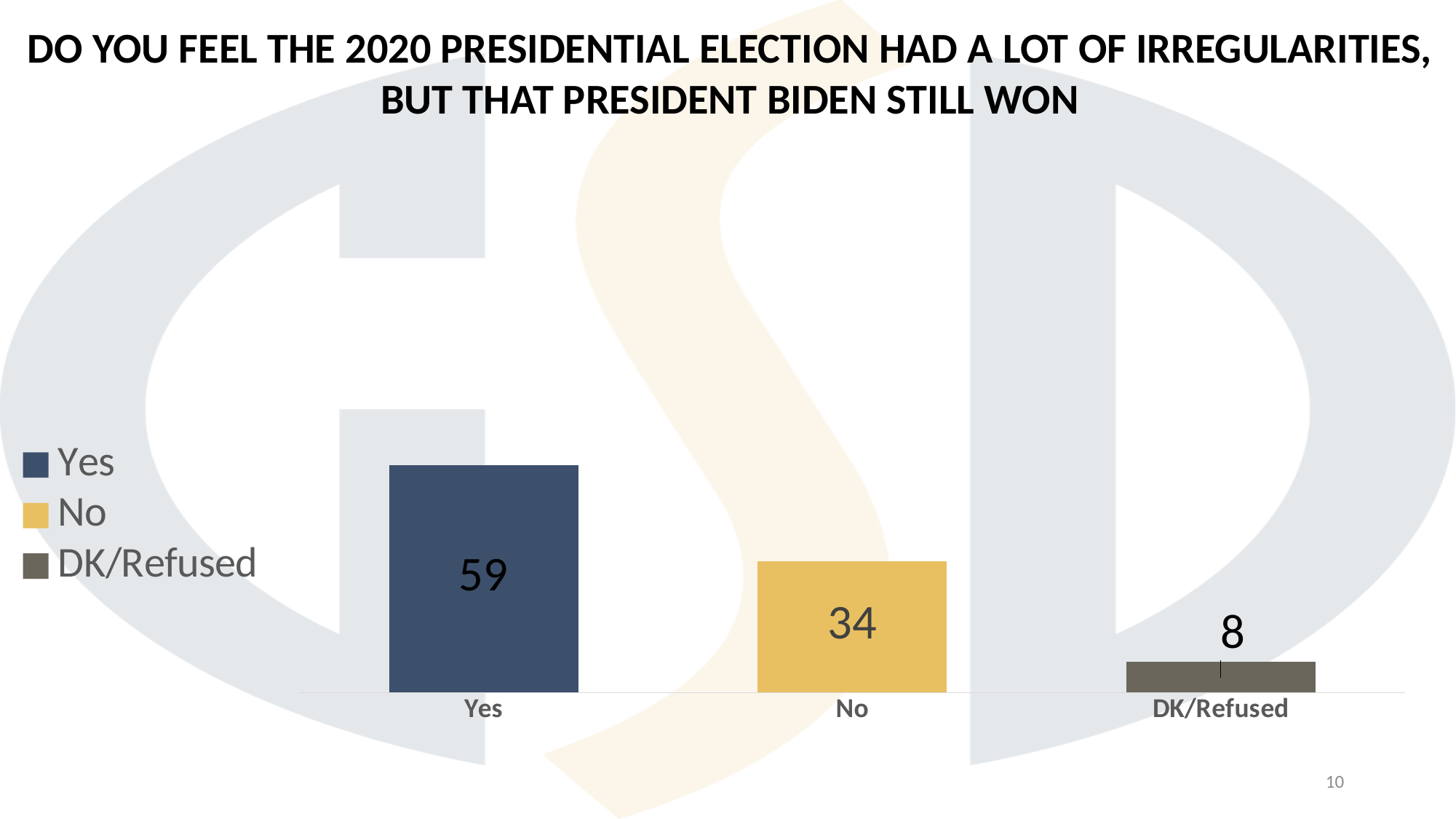
What is the value for No? 34 What kind of chart is shown on the slide? Bar chart How many entries does the legend list? 3 What is the difference between the values for Yes and No? 25 What is the value for Yes? 59 What colour is the bar for No? Yellow What is the difference between the values for No and DK/Refused? 26 Which is larger, the value for Yes or the value for No? Yes What is the value for DK/Refused? 8 Which category has the lowest value? DK/Refused Which category has the highest value? Yes How many categories are shown in the chart? 3